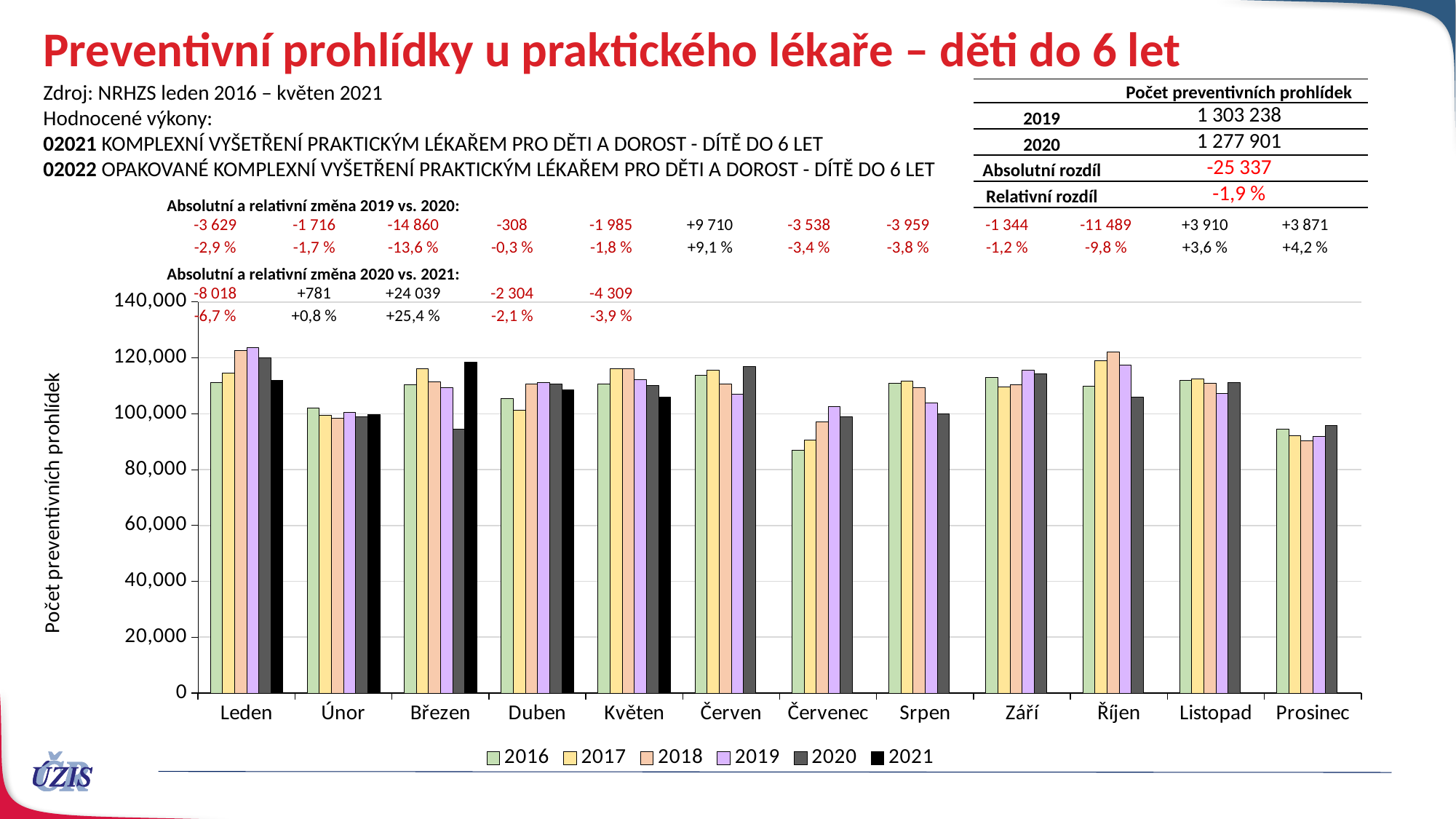
Which years are listed in the chart legend? 2016, 2017, 2018, 2019, 2020, 2021 In Březen, which is larger: the value for 2020 or the value for 2021? 2021 Which month has the lowest value for the 2016 series? Červenec How many series does the chart legend list? 6 In Červen, which is larger: the value for 2019 or the value for 2020? 2020 What is the label of the vertical axis of the chart? Počet preventivních prohlídek Is the value for 2020 in Březen greater or less than 100,000? less Is the value for 2019 in Leden greater or less than 120,000? greater According to the annotation above the chart, what is the absolute change 2019 vs. 2020 for Březen? -14 860 How many months (categories) are shown on the x axis of the chart? 12 Is the value for 2016 in Červenec greater or less than 100,000? less What kind of chart is shown on the slide? bar chart